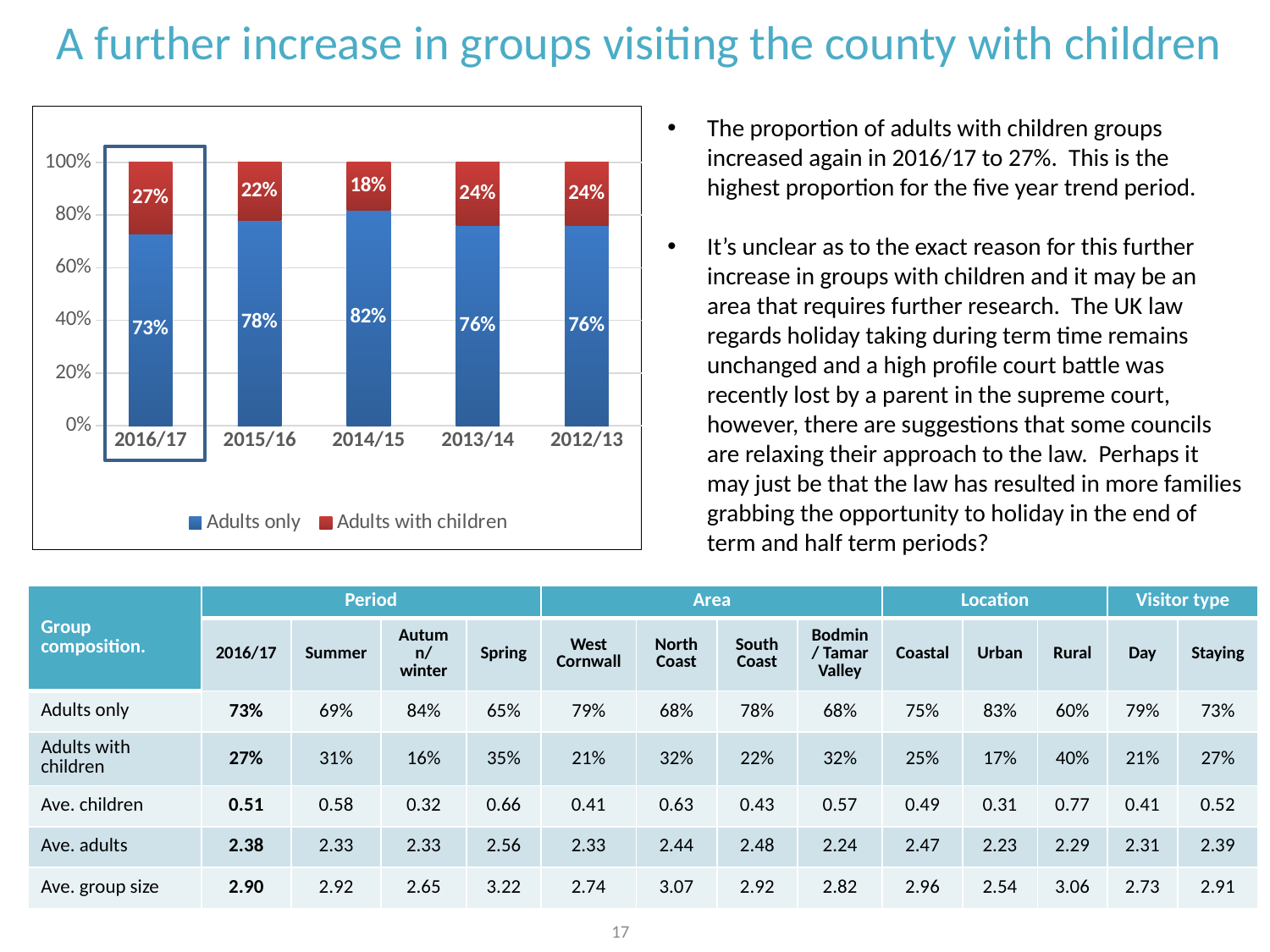
What is the total of the stacked bar for 2012/13? 100% How many series does the chart legend list? 2 Which is larger: the Adults with children share in 2016/17 or in 2013/14? 2016/17 What is the value for Adults with children in 2015/16? 22% Which year has the lowest proportion of adults with children groups? 2014/15 Which year has the highest proportion of adults with children groups? 2016/17 Which series is shown in red in the chart? Adults with children How many years are shown on the x axis of the chart? 5 What percentage of groups in 2016/17 were adults with children? 27% What is the difference between the Adults only share in 2014/15 and in 2016/17? 9% What percentage of groups in 2014/15 were adults only? 82% What type of chart is shown on the slide? Stacked bar chart